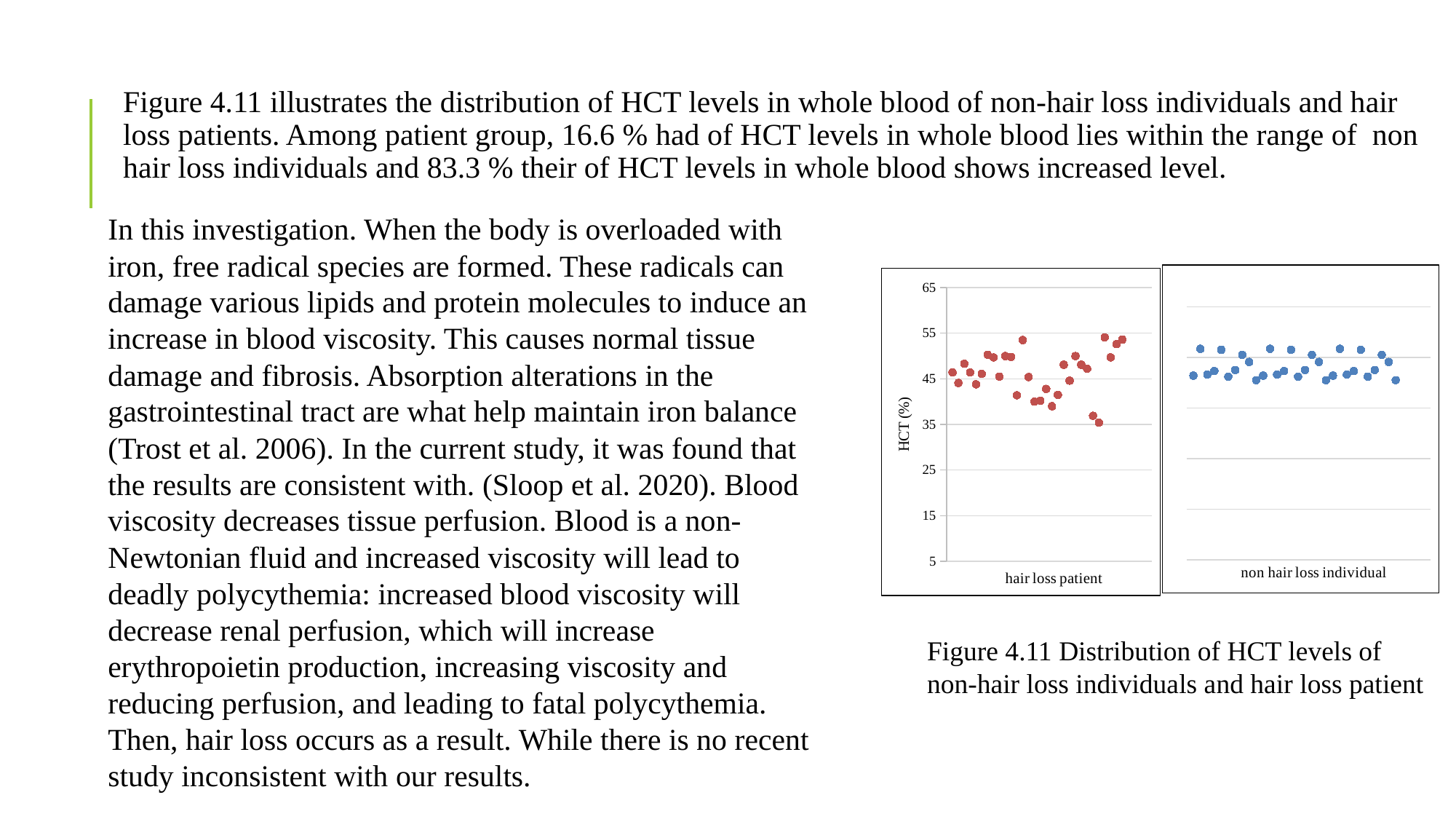
What is the label on the vertical axis of the charts? HCT (%) Which chart contains the lowest plotted HCT value, 'hair loss patient' or 'non hair loss individual'? hair loss patient Which chart contains the highest plotted HCT value, 'hair loss patient' or 'non hair loss individual'? hair loss patient In the 'hair loss patient' chart, is the lowest plotted value greater or less than 45? less What is the highest tick value shown on the vertical axis of the 'hair loss patient' chart? 65 In the 'hair loss patient' chart, is the highest plotted value greater or less than 45? greater In the 'non hair loss individual' chart, is the lowest plotted value greater or less than 35? greater What kind of chart is used for the 'hair loss patient' panel? scatter chart What colour are the points in the 'hair loss patient' chart? red How many chart panels are shown on the slide? 2